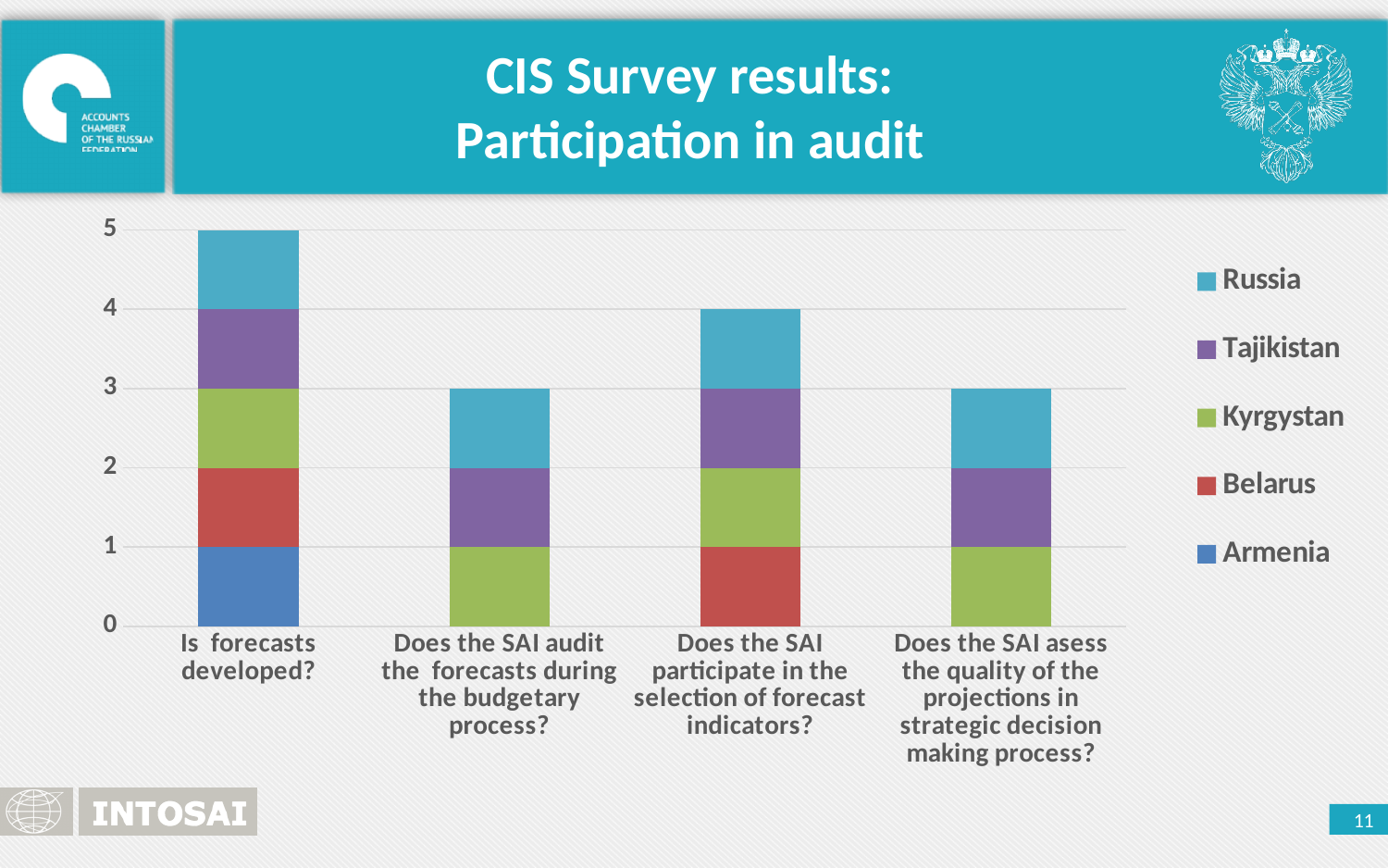
Is the total for 'Does the SAI participate in the selection of forecast indicators?' larger than the total for 'Does the SAI asess the quality of the projections in strategic decision making process?' Yes Which country appears only in the 'Is forecasts developed?' bar? Armenia What is the difference between the total for 'Is forecasts developed?' and the total for 'Does the SAI audit the forecasts during the budgetary process?' 2 Which country is shown in the top segment of every stacked bar? Russia What is the total height of the stacked bar for 'Is forecasts developed?' 5 How many series does the legend list? 5 Is the total for 'Does the SAI asess the quality of the projections in strategic decision making process?' greater or less than 4? less What is the total height of the stacked bar for 'Does the SAI audit the forecasts during the budgetary process?' 3 What kind of chart is shown on the slide? Stacked bar chart How many question categories are shown along the x axis? 4 Which question category has the tallest stacked bar? Is forecasts developed? What is the total height of the stacked bar for 'Does the SAI participate in the selection of forecast indicators?' 4